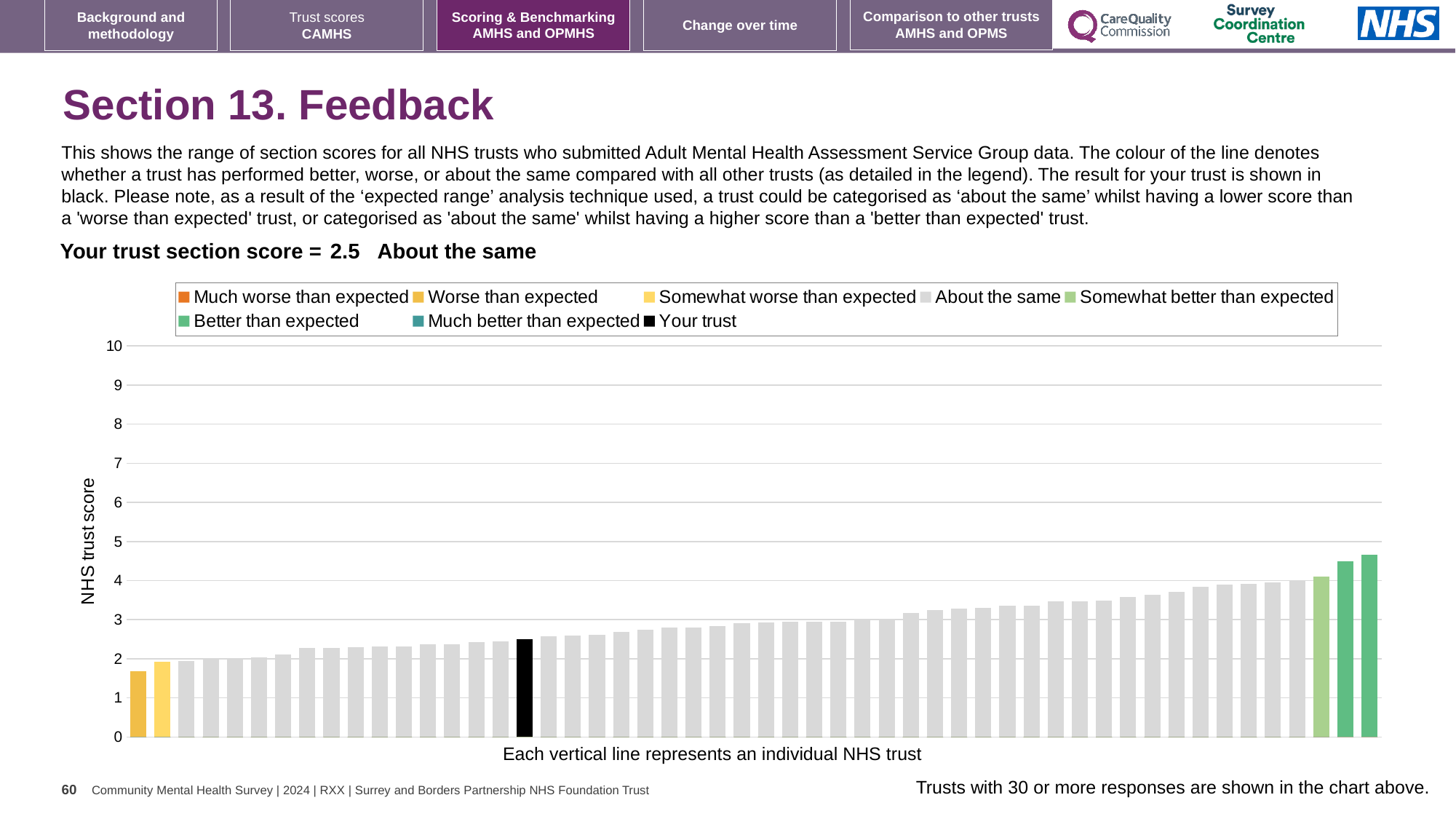
Is the value of the shortest bar (leftmost) greater or less than 2? less What is the section score for your trust shown on the slide? 2.5 What kind of chart is shown on the slide? bar chart Do the bar values rise or fall from left to right along the x axis? rise How is your trust's section score categorised compared with other trusts? About the same Is the value of the black 'Your trust' bar greater or less than 2? greater How many entries does the chart legend list? 8 Which legend category does the shortest bar in the chart belong to? Worse than expected Which legend category does the tallest bar in the chart belong to? Better than expected Is the value of the tallest bar (rightmost) greater or less than 4? greater What is the label on the vertical axis of the chart? NHS trust score